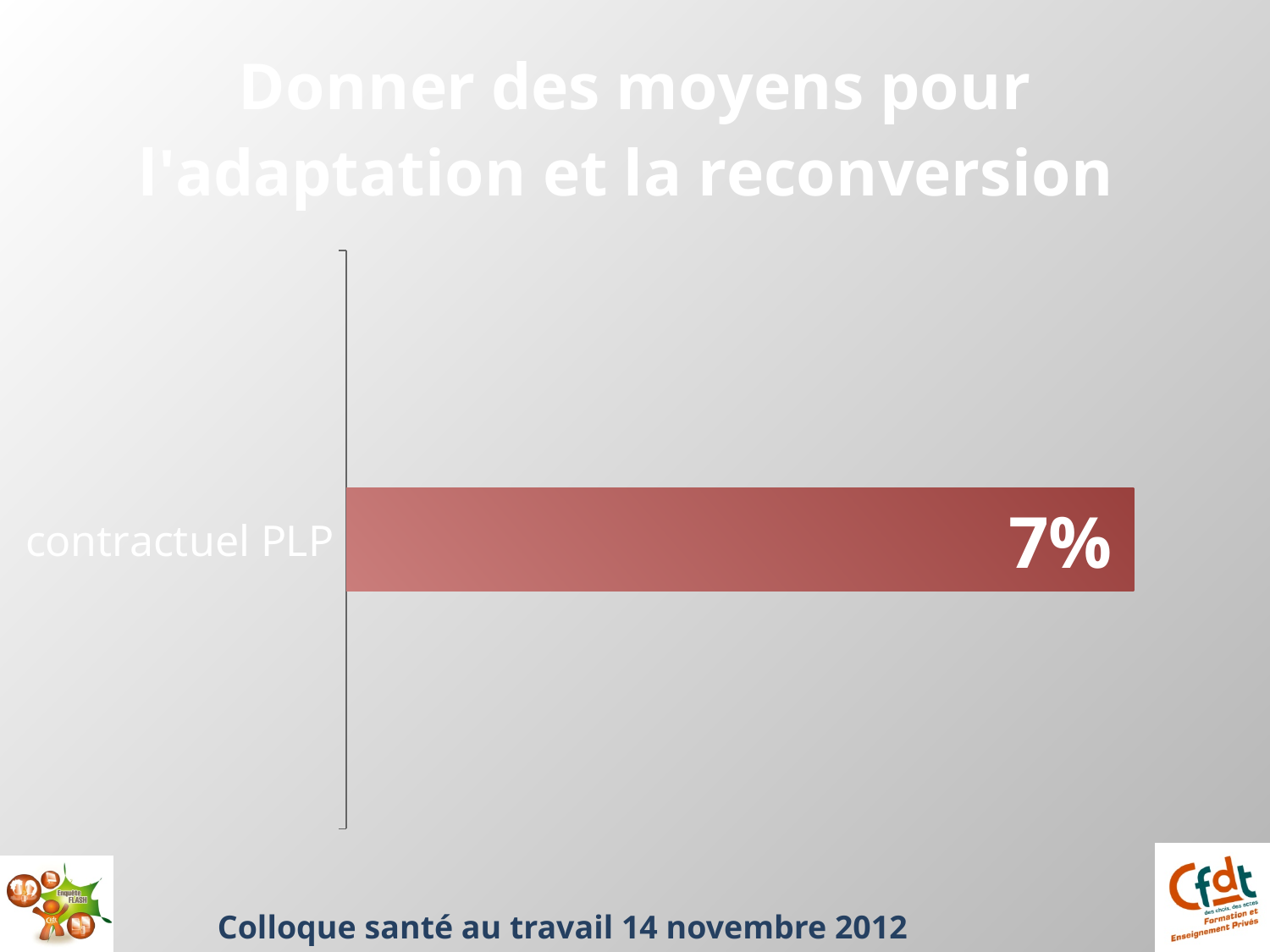
What is the label of the single category in the chart? contractuel PLP Is the value for contractuel PLP greater or less than 10%? less What kind of chart is shown on the slide? bar chart What colour is the bar for contractuel PLP? red What is the value shown for contractuel PLP? 7% How many categories are plotted in the chart? 1